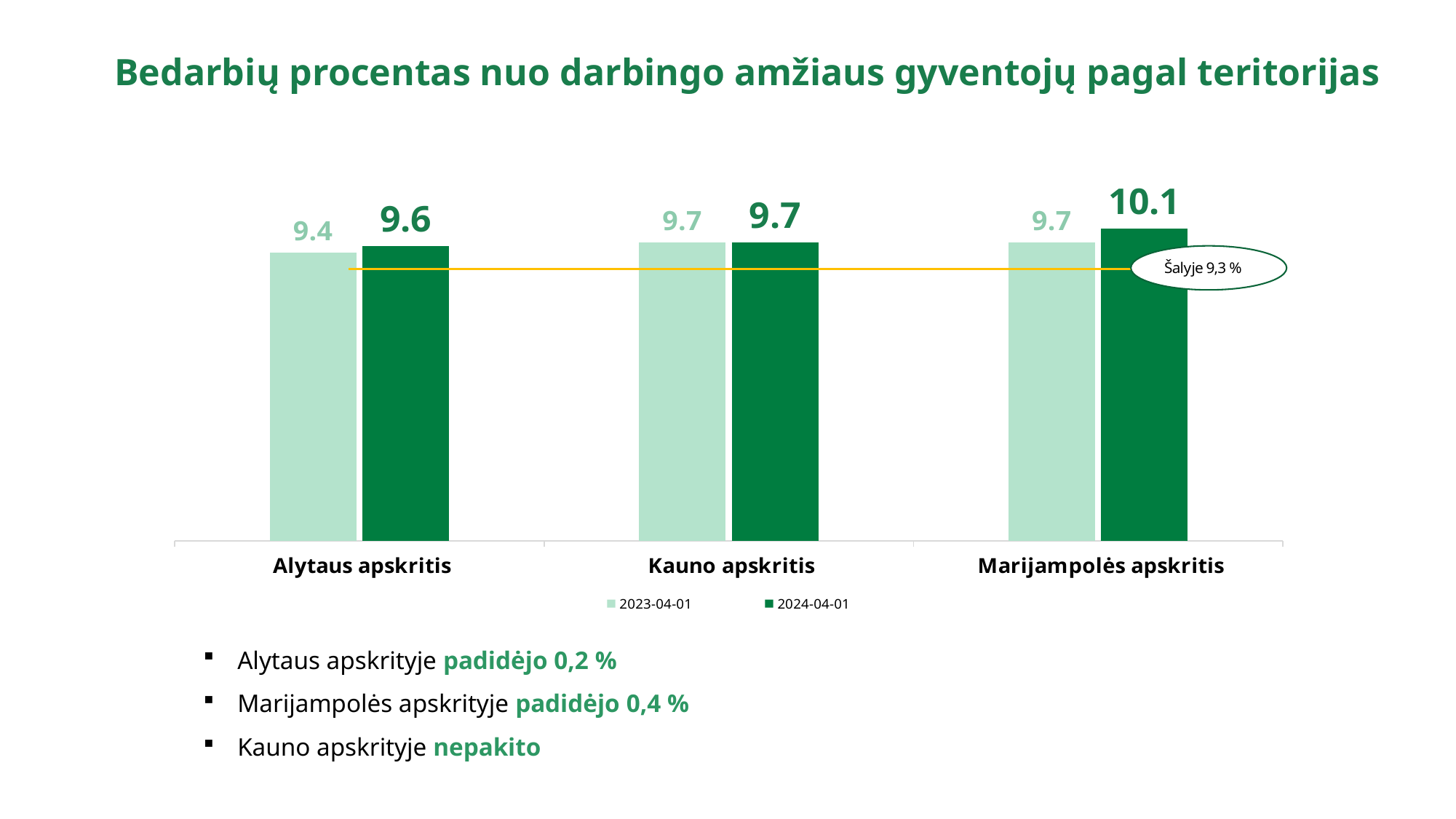
How many series does the legend list? 2 Which is larger for Alytaus apskritis: the 2023-04-01 value or the 2024-04-01 value? 2024-04-01 What is the value for Alytaus apskritis for 2023-04-01? 9.4 What is the value for Alytaus apskritis for 2024-04-01? 9.6 What is the value for Marijampolės apskritis for 2024-04-01? 10.1 What kind of chart is shown on the slide? Bar chart What is the difference between the 2024-04-01 and 2023-04-01 values for Marijampolės apskritis? 0.4 What is the value for Marijampolės apskritis for 2023-04-01? 9.7 Which category has the lowest value for 2023-04-01? Alytaus apskritis What is the value for Kauno apskritis for 2024-04-01? 9.7 How many categories are shown on the x axis? 3 Which category has the highest value for 2024-04-01? Marijampolės apskritis